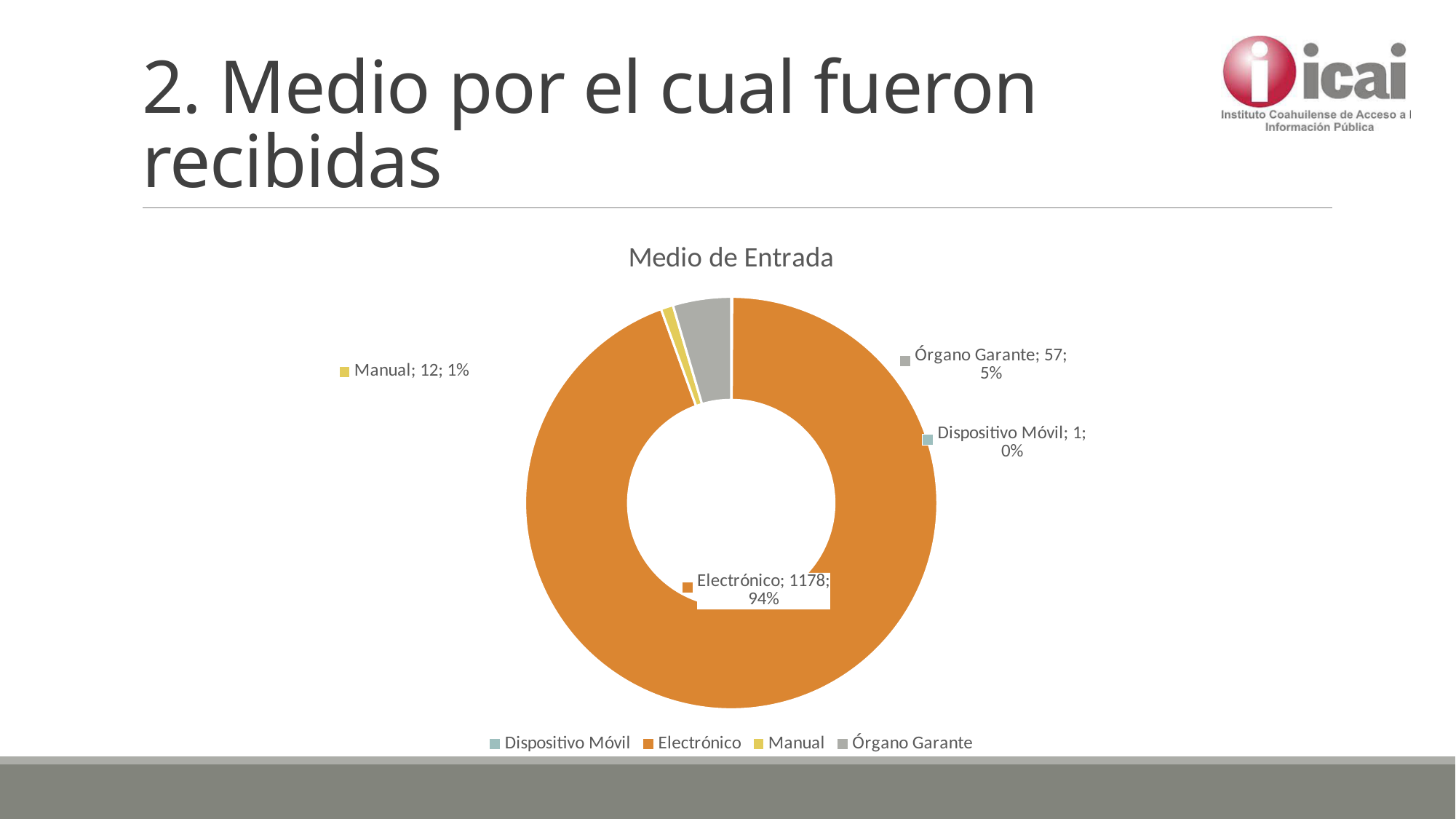
What is the difference between the values for Electrónico and Órgano Garante? 1121 What is the value for Manual? 12 What is the title of the chart? Medio de Entrada What share of the pie does Electrónico represent? 94% What is the difference between the values for Órgano Garante and Manual? 45 Which category has the highest value? Electrónico What is the value for Órgano Garante? 57 What is the value for Dispositivo Móvil? 1 What is the value for Electrónico? 1178 Which category has the lowest value? Dispositivo Móvil Which is larger, the value for Manual or the value for Órgano Garante? Órgano Garante How many categories does the chart show? 4